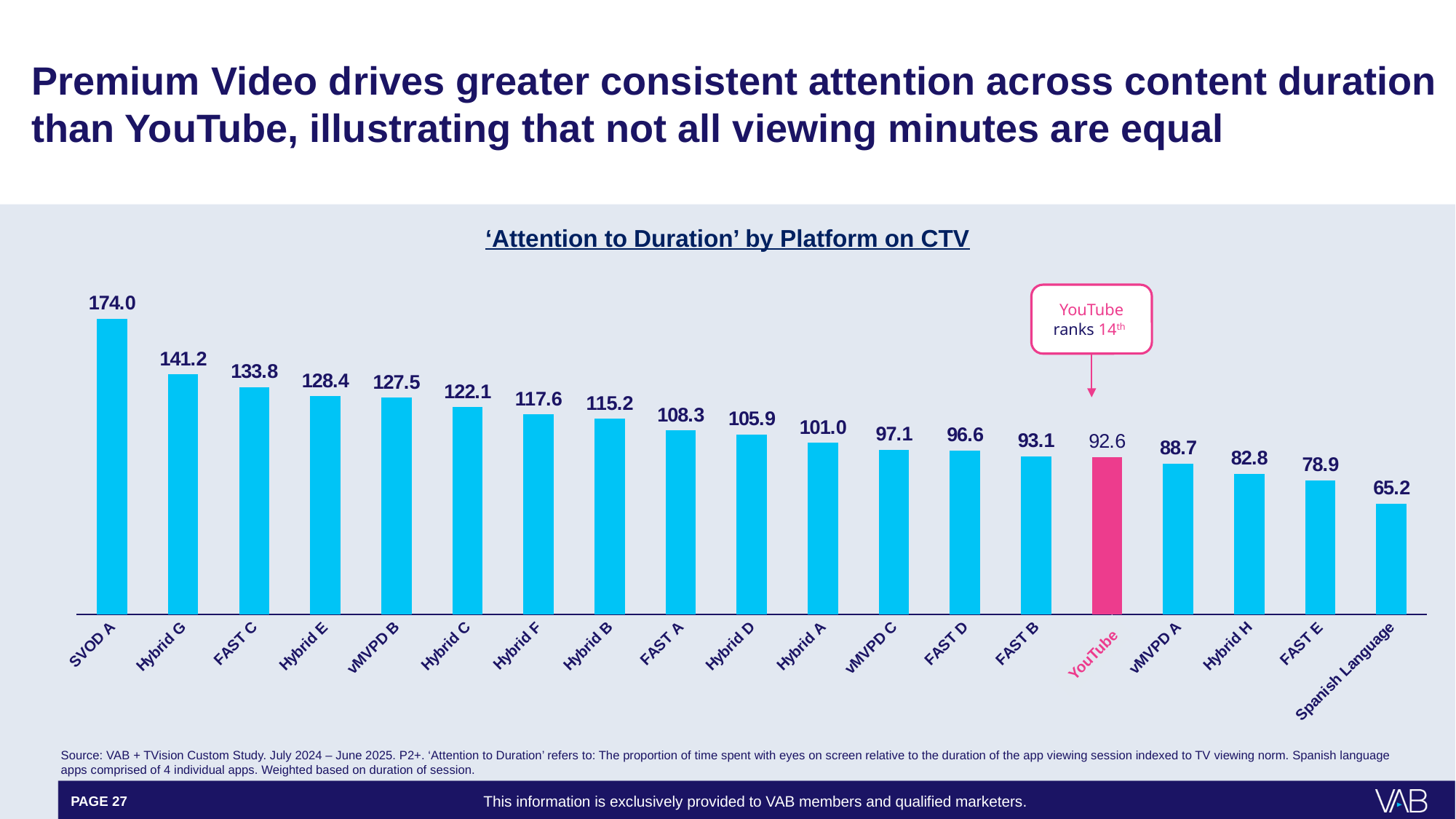
What type of chart is used on this slide? Bar chart What is the value shown for YouTube? 92.6 Which platform has the lowest 'Attention to Duration' value? Spanish Language According to the callout, what rank does YouTube hold? 14th Which has a higher value, FAST A or vMVPD A? FAST A What is the value for Hybrid C? 122.1 What is the difference between the values for SVOD A and YouTube? 81.4 How many platforms are shown in the chart? 19 What is the difference between the values for Hybrid G and FAST C? 7.4 What is the value for Spanish Language? 65.2 Which platform has the highest 'Attention to Duration' value? SVOD A What is the 'Attention to Duration' value for SVOD A? 174.0